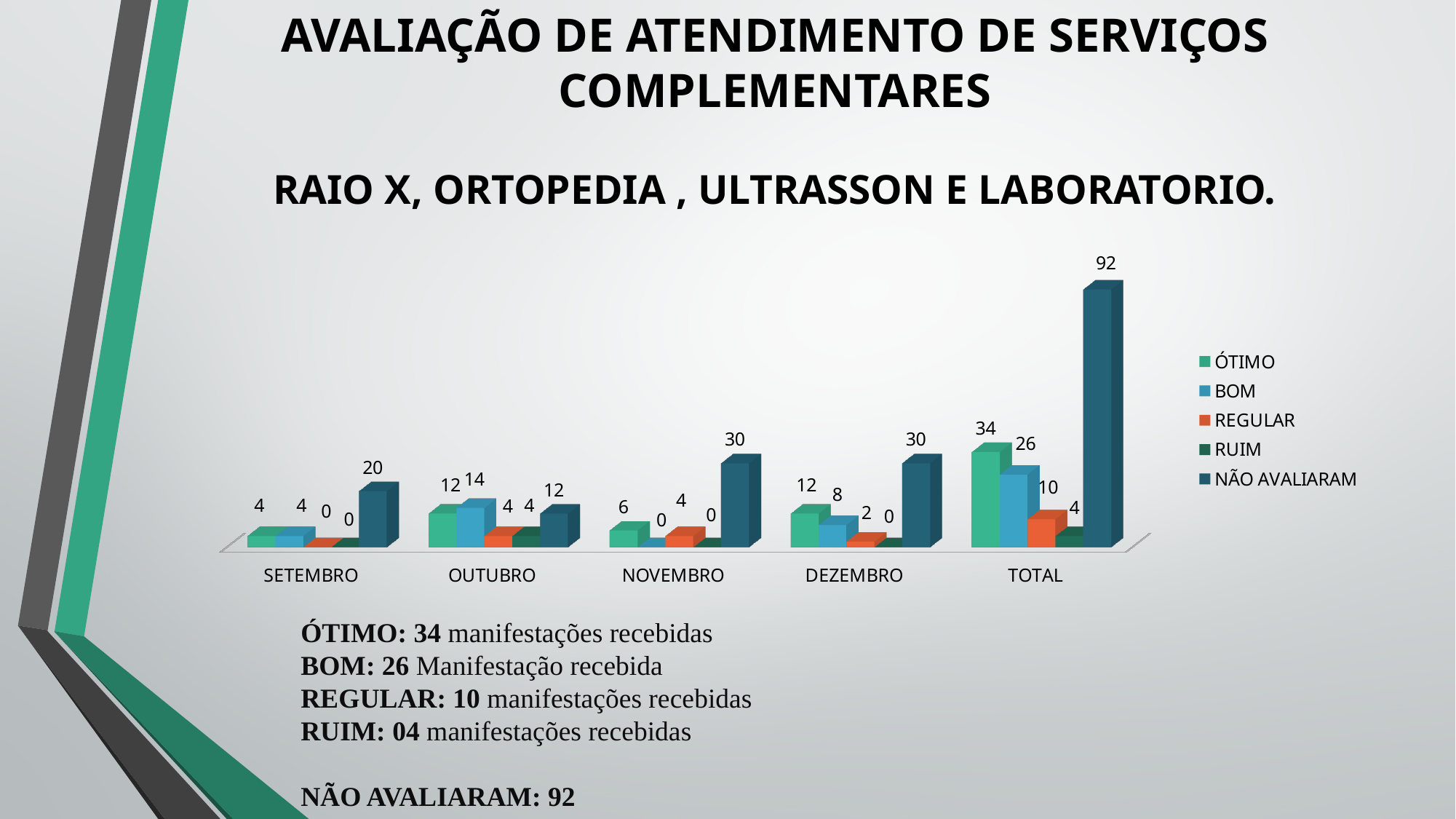
What is the value for NÃO AVALIARAM in the TOTAL category? 92 What is the difference between ÓTIMO and BOM in the TOTAL category? 8 How many series does the legend list? 5 What is the value for REGULAR in DEZEMBRO? 2 What is the value for NÃO AVALIARAM in SETEMBRO? 20 What is the value for ÓTIMO in NOVEMBRO? 6 Which is larger in OUTUBRO, ÓTIMO or BOM? BOM Which category has the highest value for NÃO AVALIARAM? TOTAL Which category has the lowest value for ÓTIMO? SETEMBRO What is the value for BOM in OUTUBRO? 14 What kind of chart is shown on the slide? Bar chart How many categories are shown on the x axis? 5